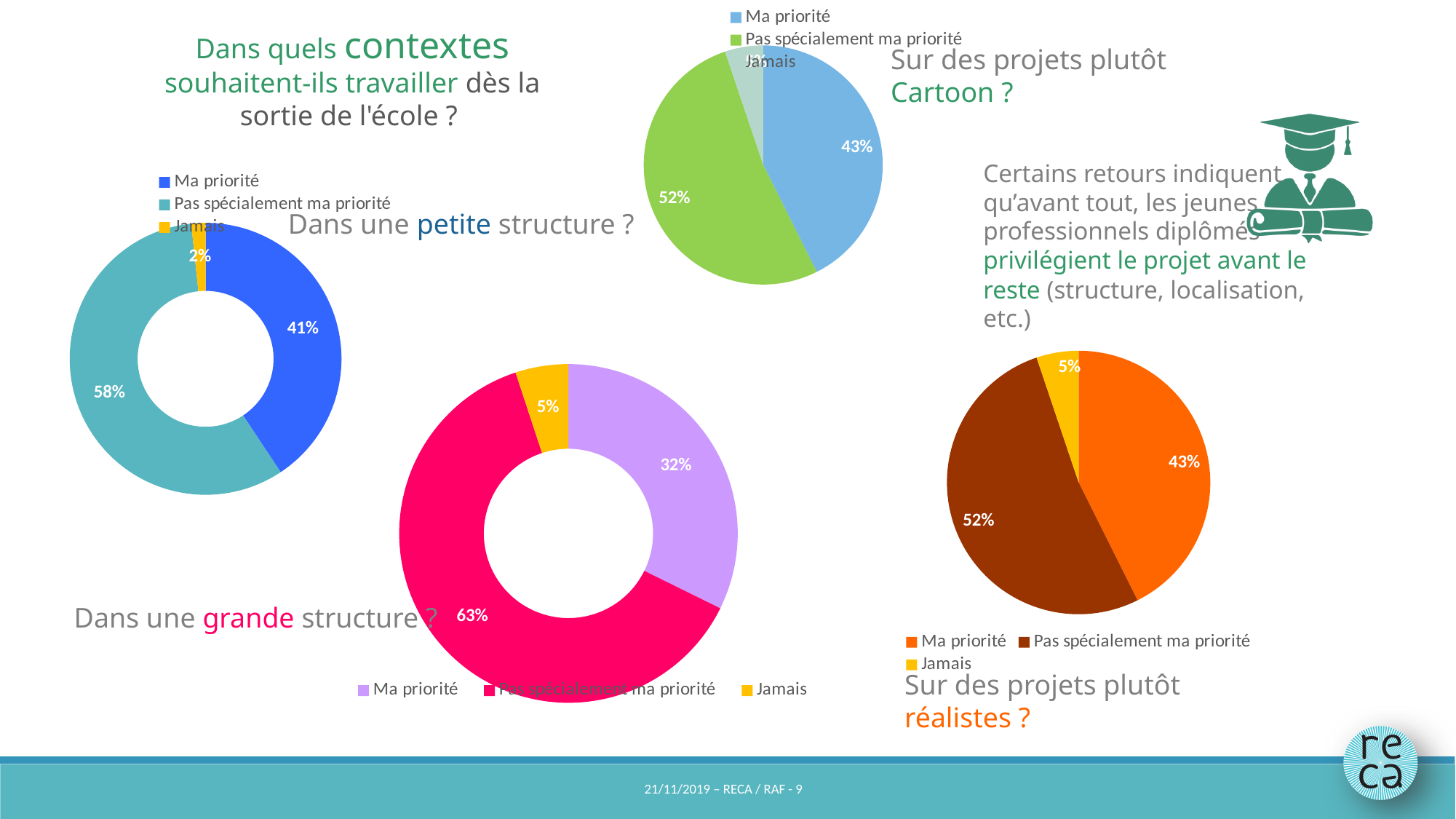
How many categories does the legend of the 'Sur des projets plutôt réalistes ?' chart list? 3 In the 'Dans une petite structure ?' chart, what percentage is shown for 'Pas spécialement ma priorité'? 58% In the 'Dans une petite structure ?' chart, what percentage is shown for 'Ma priorité'? 41% In the 'Sur des projets plutôt réalistes ?' chart, what percentage is shown for 'Pas spécialement ma priorité'? 52% In the 'Sur des projets plutôt Cartoon ?' chart, what percentage is shown for 'Ma priorité'? 43% What type of chart is 'Dans une grande structure ?'? Donut chart In the 'Dans une grande structure ?' chart, what is the difference between 'Pas spécialement ma priorité' and 'Ma priorité'? 31 percentage points In the 'Sur des projets plutôt réalistes ?' chart, what percentage is shown for 'Jamais'? 5% In the 'Sur des projets plutôt Cartoon ?' chart, which is larger: 'Ma priorité' or 'Pas spécialement ma priorité'? Pas spécialement ma priorité In the 'Dans une grande structure ?' chart, what percentage is shown for 'Pas spécialement ma priorité'? 63% In the 'Dans une petite structure ?' chart, which category has the smallest share? Jamais In the 'Dans une grande structure ?' chart, which category has the largest share? Pas spécialement ma priorité